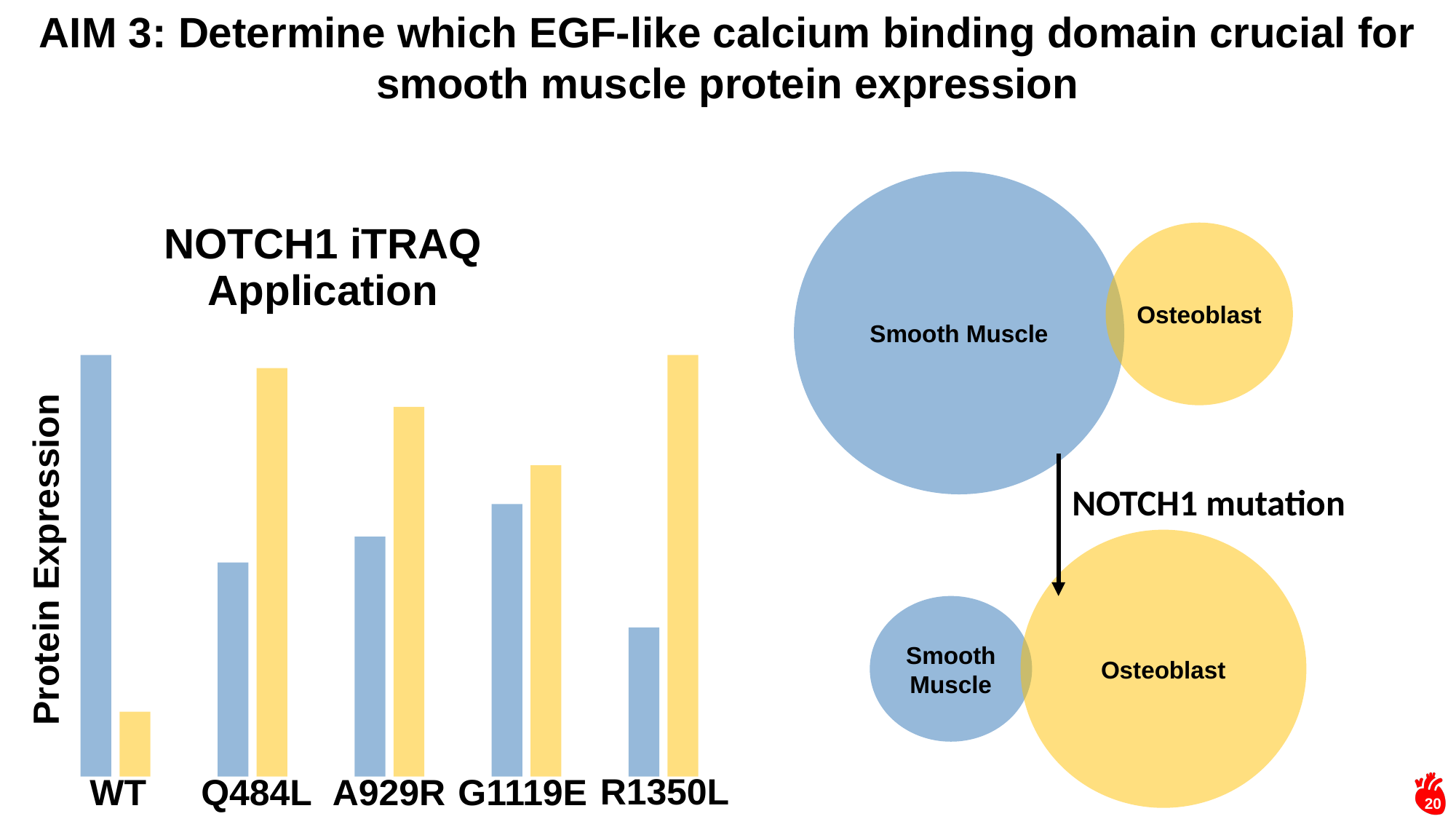
In the NOTCH1 iTRAQ Application chart, which category has the tallest yellow bar? R1350L In the NOTCH1 iTRAQ Application chart, which category has the tallest blue bar? WT What kind of chart is the NOTCH1 iTRAQ Application chart? bar chart In the NOTCH1 iTRAQ Application chart, for WT, is the blue bar or the yellow bar taller? blue In the NOTCH1 iTRAQ Application chart, for Q484L, is the blue bar or the yellow bar taller? yellow What is the title of the bar chart on the left of the slide? NOTCH1 iTRAQ Application How many categories are shown on the x axis of the NOTCH1 iTRAQ Application chart? 5 In the NOTCH1 iTRAQ Application chart, do the blue bars rise or fall from Q484L to G1119E? rise In the NOTCH1 iTRAQ Application chart, which category has the shortest blue bar? R1350L What is the label of the vertical axis of the NOTCH1 iTRAQ Application chart? Protein Expression In the NOTCH1 iTRAQ Application chart, do the yellow bars rise or fall from Q484L to G1119E? fall In the NOTCH1 iTRAQ Application chart, which category has the shortest yellow bar? WT